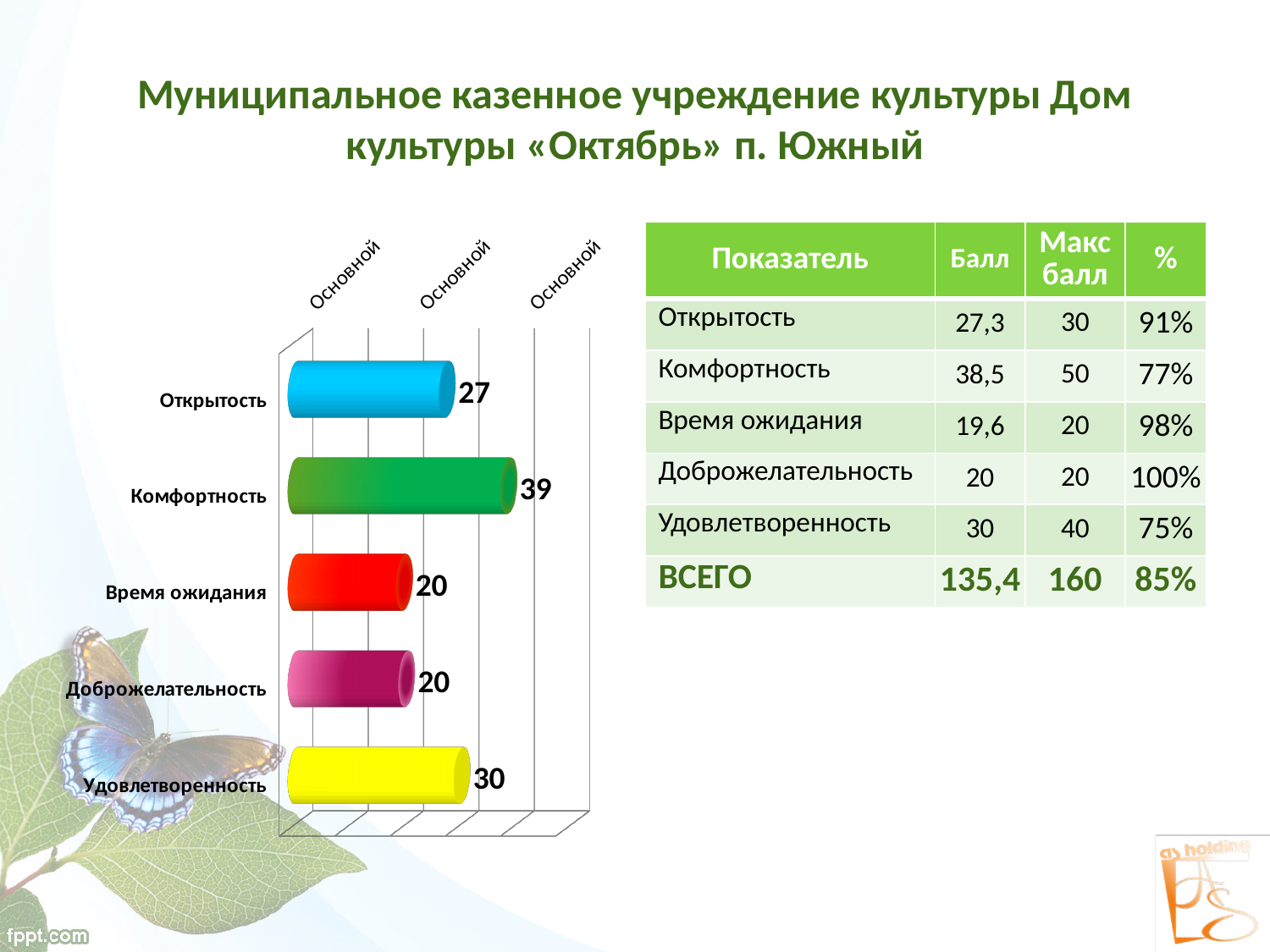
Which two categories in the bar chart share the same value of 20? Время ожидания and Доброжелательность What is the difference between the values for Удовлетворенность and Доброжелательность in the bar chart? 10 How many categories are plotted in the bar chart? 5 What colour is the bar for Удовлетворенность in the bar chart? Yellow What is the value shown for Удовлетворенность in the bar chart? 30 What is the value shown for Открытость in the bar chart? 27 Which category has the highest value in the bar chart? Комфортность Which is larger in the bar chart, the value for Удовлетворенность or the value for Открытость? Удовлетворенность What is the difference between the values for Комфортность and Открытость in the bar chart? 12 What type of chart is shown on the slide? Bar chart What is the value shown for Комфортность in the bar chart? 39 What is the value shown for Время ожидания in the bar chart? 20